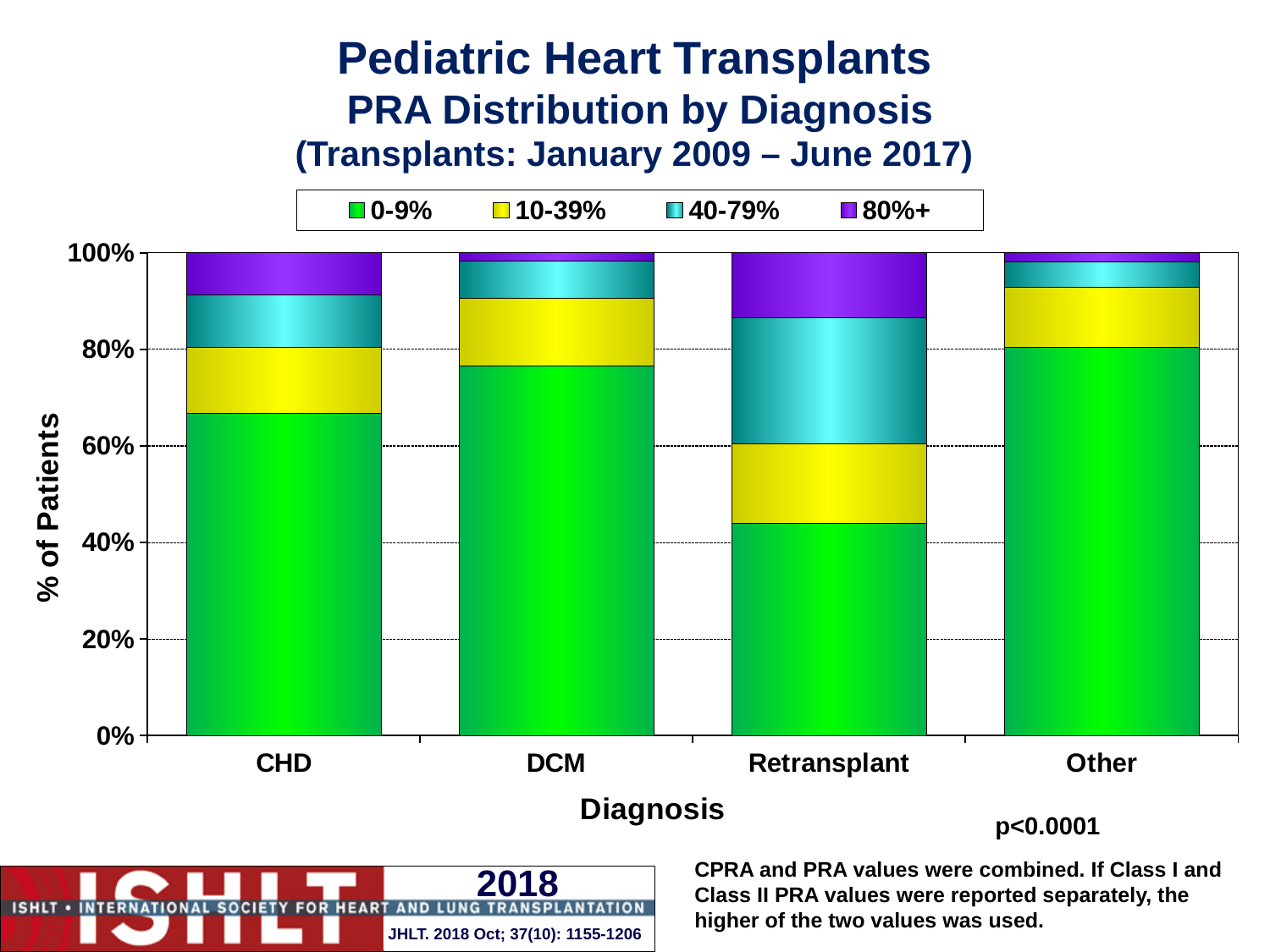
What is the label on the y axis? % of Patients Is the 0-9% PRA share for Retransplant greater or less than 60%? less What kind of chart is shown on the slide? Stacked bar chart Which is larger, the 0-9% PRA share for CHD or for DCM? DCM Which diagnosis has the largest 80%+ PRA segment? Retransplant Which diagnosis has the largest 40-79% PRA segment? Retransplant Is the 0-9% PRA share for CHD greater or less than 60%? greater How many series does the legend list? 4 Is the 0-9% PRA share for DCM greater or less than 80%? less Which diagnosis has the smallest 0-9% PRA segment? Retransplant What is the total height of each stacked bar on the y axis? 100% How many diagnosis categories are shown on the x axis? 4